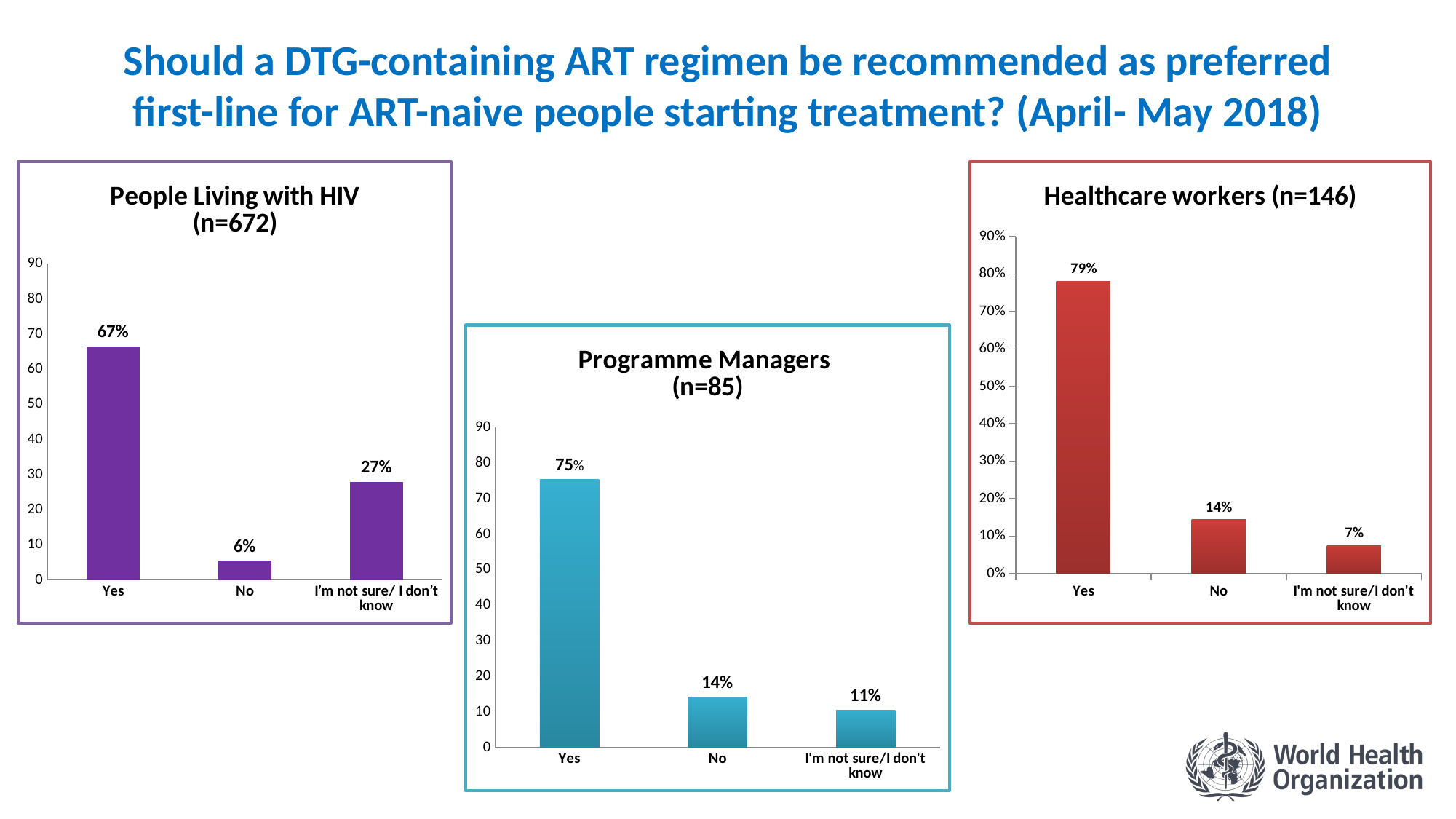
In the 'People Living with HIV (n=672)' chart, what is the difference between the 'Yes' and 'I'm not sure/ I don't know' values? 40% In the 'Healthcare workers (n=146)' chart, which category has the highest value? Yes What colour are the bars in the 'Programme Managers (n=85)' chart? Blue In the 'People Living with HIV (n=672)' chart, which category has the lowest value? No In the 'Healthcare workers (n=146)' chart, what is the value for 'No'? 14% In the 'People Living with HIV (n=672)' chart, what is the value for 'Yes'? 67% What type of chart is the 'Healthcare workers (n=146)' chart? Bar chart How many charts are shown on the slide? 3 How many categories are shown in the 'Programme Managers (n=85)' chart? 3 In the 'Programme Managers (n=85)' chart, which is larger: the value for 'No' or the value for 'I'm not sure/I don't know'? No In the 'Healthcare workers (n=146)' chart, what is the difference between the 'No' and 'I'm not sure/I don't know' values? 7% In the 'Programme Managers (n=85)' chart, what is the value for 'I'm not sure/I don't know'? 11%